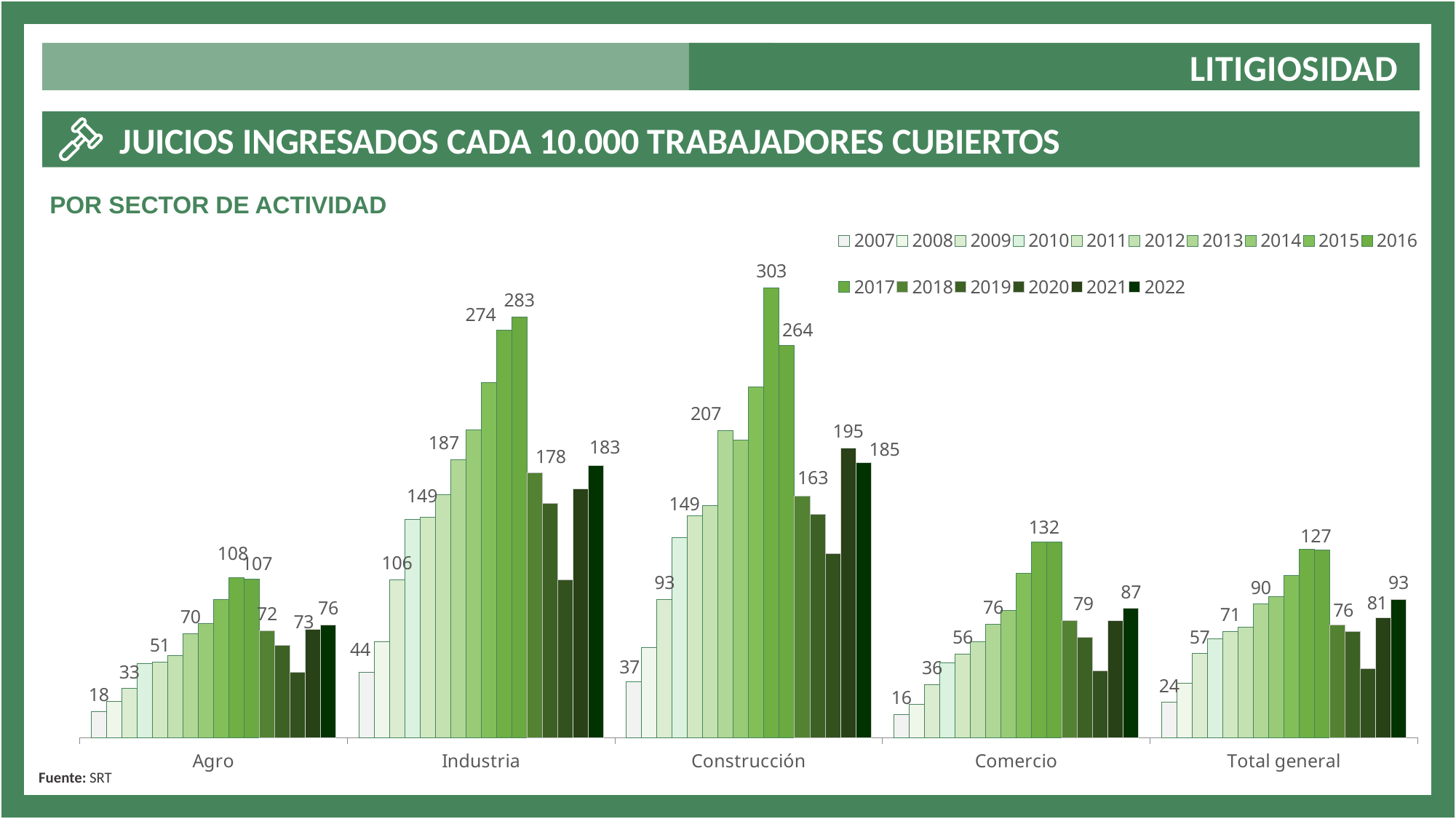
What is the value for Comercio in 2007? 16 What kind of chart is shown on the slide? bar chart What is the value for Industria in 2022? 183 What is the value for Agro in 2007? 18 Which is larger in 2022: Comercio or Total general? Total general How many sector categories are shown along the x axis? 5 What is the value for Construcción in 2022? 185 Which sector has the lowest value in 2007? Comercio What is the difference between the 2022 values for Construcción and Industria? 2 How many years (series) does the legend list? 16 What is the highest value shown for Construcción? 303 Which sector reaches the highest value on the chart? Construcción